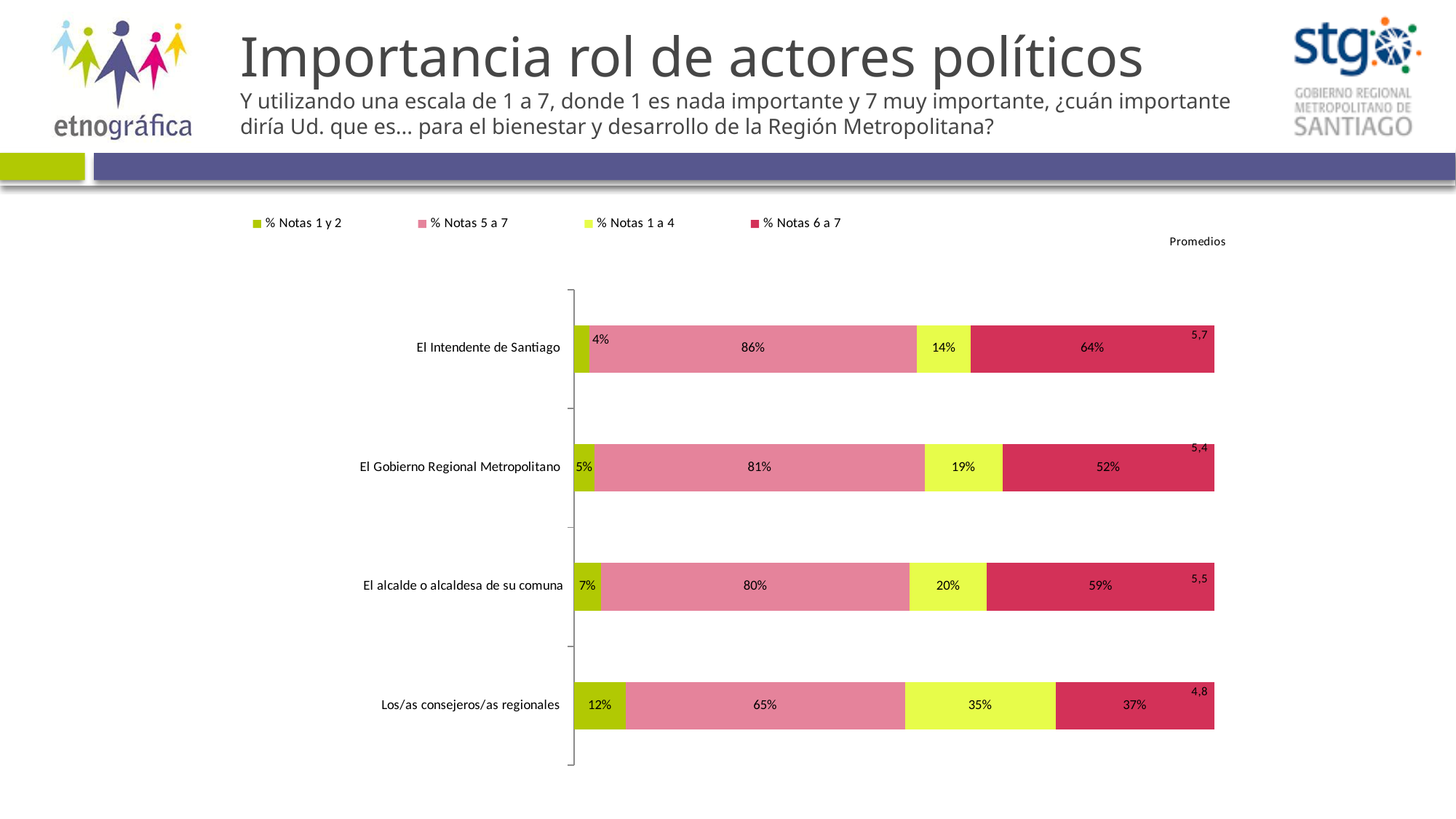
What is the value of % Notas 5 a 7 for El Intendente de Santiago? 86% What kind of chart is shown on the slide? Stacked bar chart Which category has the highest value for % Notas 6 a 7? El Intendente de Santiago Which category has the lowest value for % Notas 5 a 7? Los/as consejeros/as regionales What is the value of % Notas 1 a 4 for El Gobierno Regional Metropolitano? 19% How many categories are shown on the chart? 4 Which is larger: % Notas 6 a 7 for El alcalde o alcaldesa de su comuna or for El Gobierno Regional Metropolitano? El alcalde o alcaldesa de su comuna How many series does the legend list? 4 What is the Promedio shown for El Intendente de Santiago? 5,7 What is the value of % Notas 1 y 2 for El alcalde o alcaldesa de su comuna? 7% What is the difference between the % Notas 1 a 4 values for Los/as consejeros/as regionales and El Intendente de Santiago? 21% What is the value of % Notas 6 a 7 for Los/as consejeros/as regionales? 37%